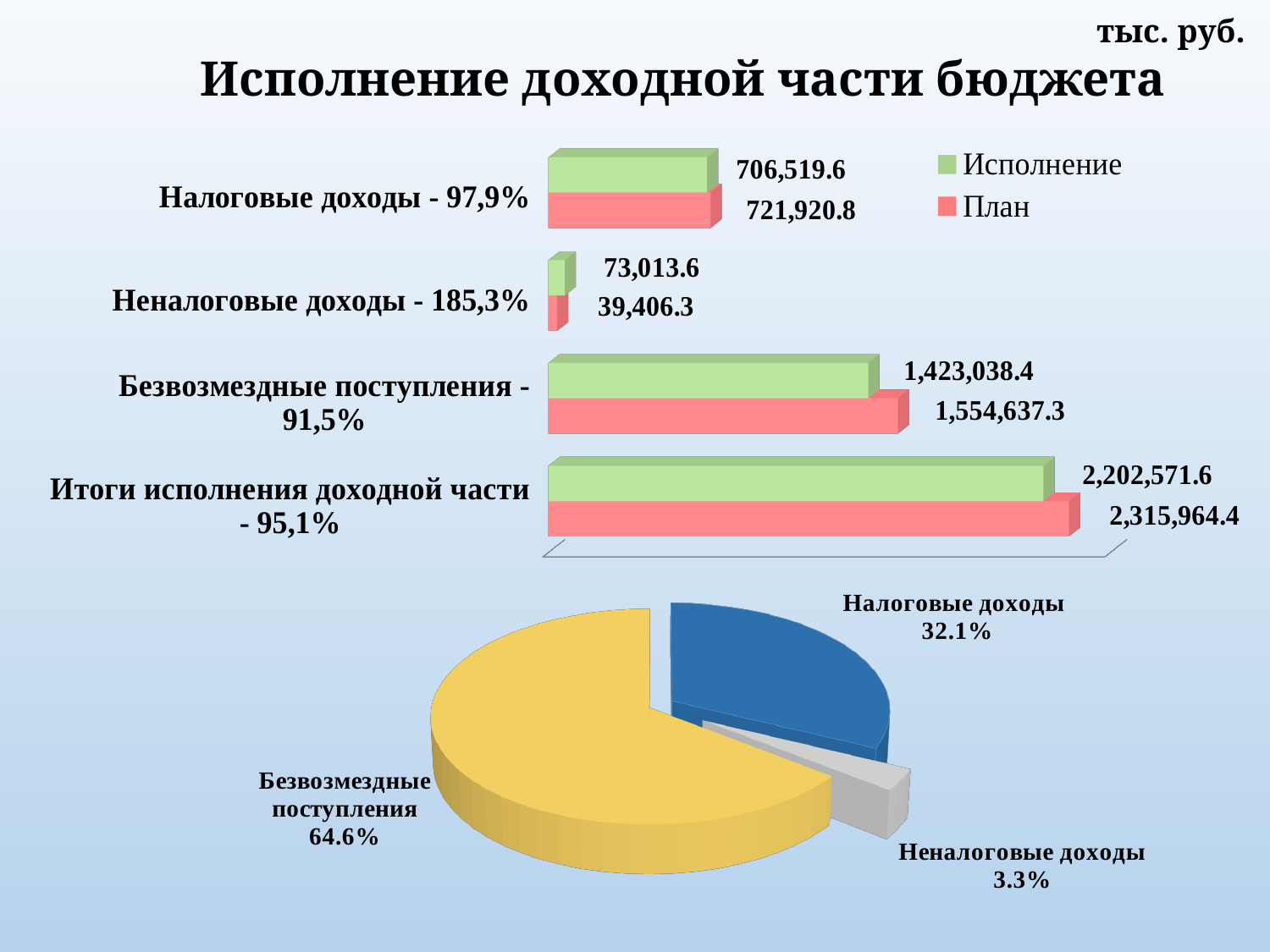
In the top bar chart, what is the План value for Безвозмездные поступления? 1,554,637.3 In the top bar chart, what is the Исполнение value for Налоговые доходы? 706,519.6 In the top bar chart, what is the План value for Неналоговые доходы? 39,406.3 How many series does the legend of the top bar chart list? 2 In the bottom pie chart, which slice is the smallest? Неналоговые доходы What type of chart is the bottom chart on the slide? Pie chart In the top bar chart, what is the difference between the Исполнение and План values for Неналоговые доходы? 33,607.3 In the top bar chart, what is the difference between the План and Исполнение values for Налоговые доходы? 15,401.2 In the top bar chart, which category has the lowest План value? Неналоговые доходы In the top bar chart, what is the Исполнение value for Итоги исполнения доходной части? 2,202,571.6 In the bottom pie chart, what share does Безвозмездные поступления have? 64.6% In the top bar chart, for Безвозмездные поступления, which is larger: Исполнение or План? План